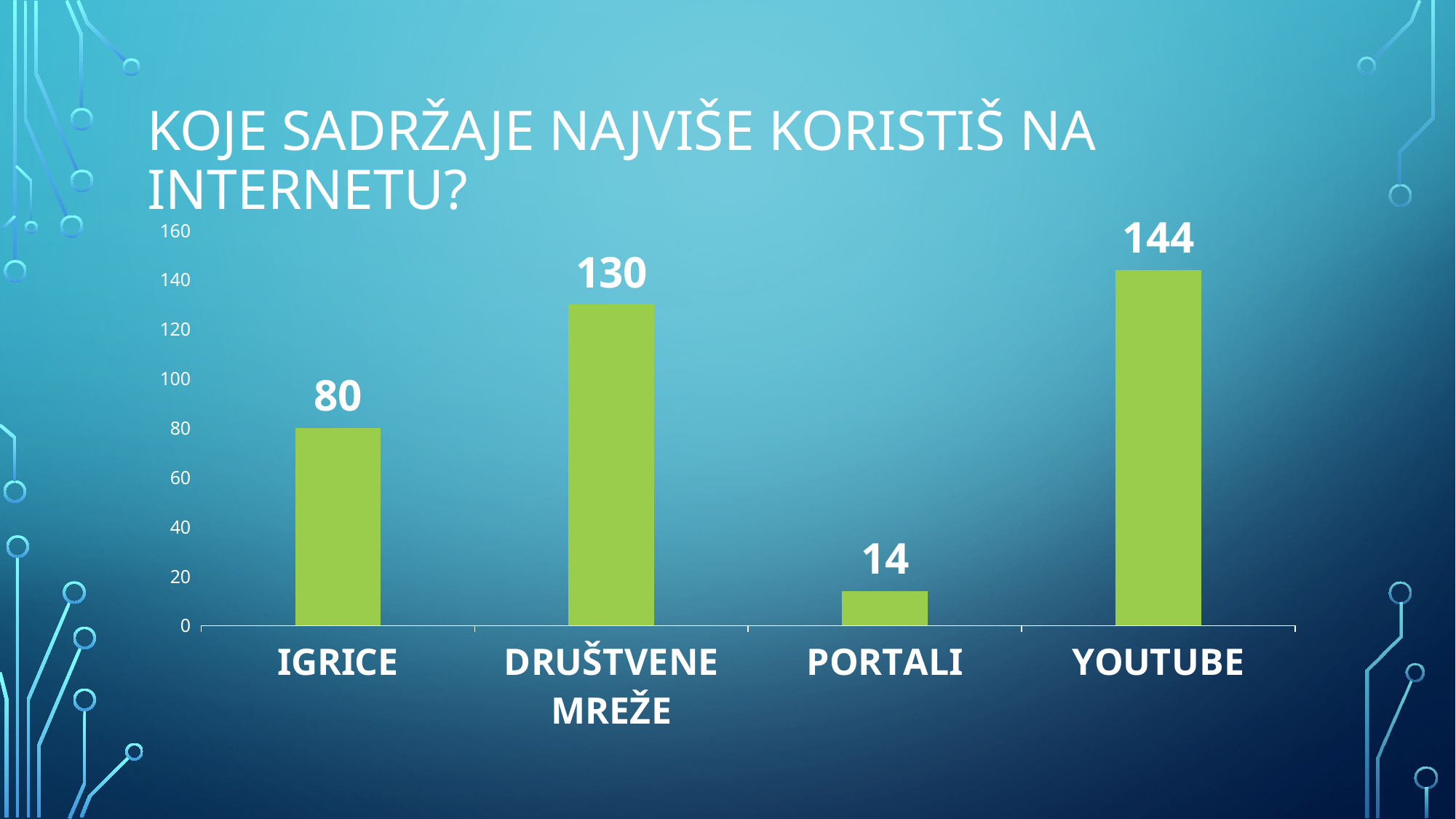
What is the value for DRUŠTVENE MREŽE? 130 Which category has the highest value? YOUTUBE What kind of chart is shown on the slide? bar chart What is the title of the slide? KOJE SADRŽAJE NAJVIŠE KORISTIŠ NA INTERNETU? What is the difference between the values for YOUTUBE and DRUŠTVENE MREŽE? 14 Which category has the lowest value? PORTALI What is the value for YOUTUBE? 144 How many categories are shown in the chart? 4 What is the value for IGRICE? 80 Which is larger, the value for IGRICE or the value for DRUŠTVENE MREŽE? DRUŠTVENE MREŽE What is the value for PORTALI? 14 What is the difference between the values for IGRICE and PORTALI? 66